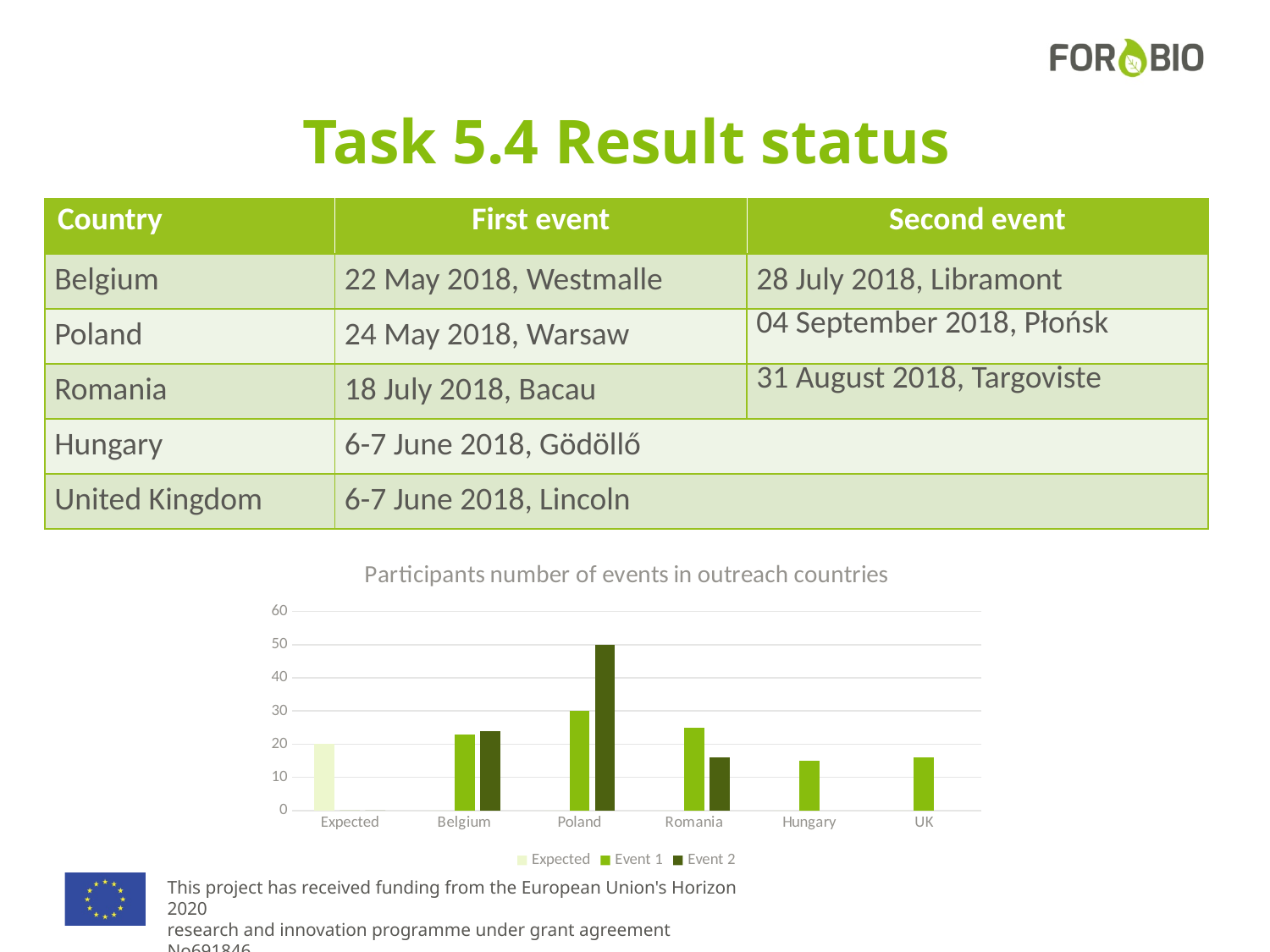
Is the Event 2 value for Romania greater or less than 20? less Which is larger, the Event 2 value for Poland or the Event 2 value for Romania? Poland How many series does the chart legend list? 3 Which category has the tallest bar in the chart? Poland Is the Event 1 value for Hungary greater or less than 20? less What is the value of the Expected bar? 20 What is the title of the chart? Participants number of events in outreach countries Is the Event 1 value for Belgium greater or less than 20? greater How many categories are shown on the x axis of the chart? 6 What type of chart is shown on the slide? bar chart Which is larger, the Event 1 value for Belgium or the Event 1 value for UK? Belgium What is the Event 2 value for Poland? 50